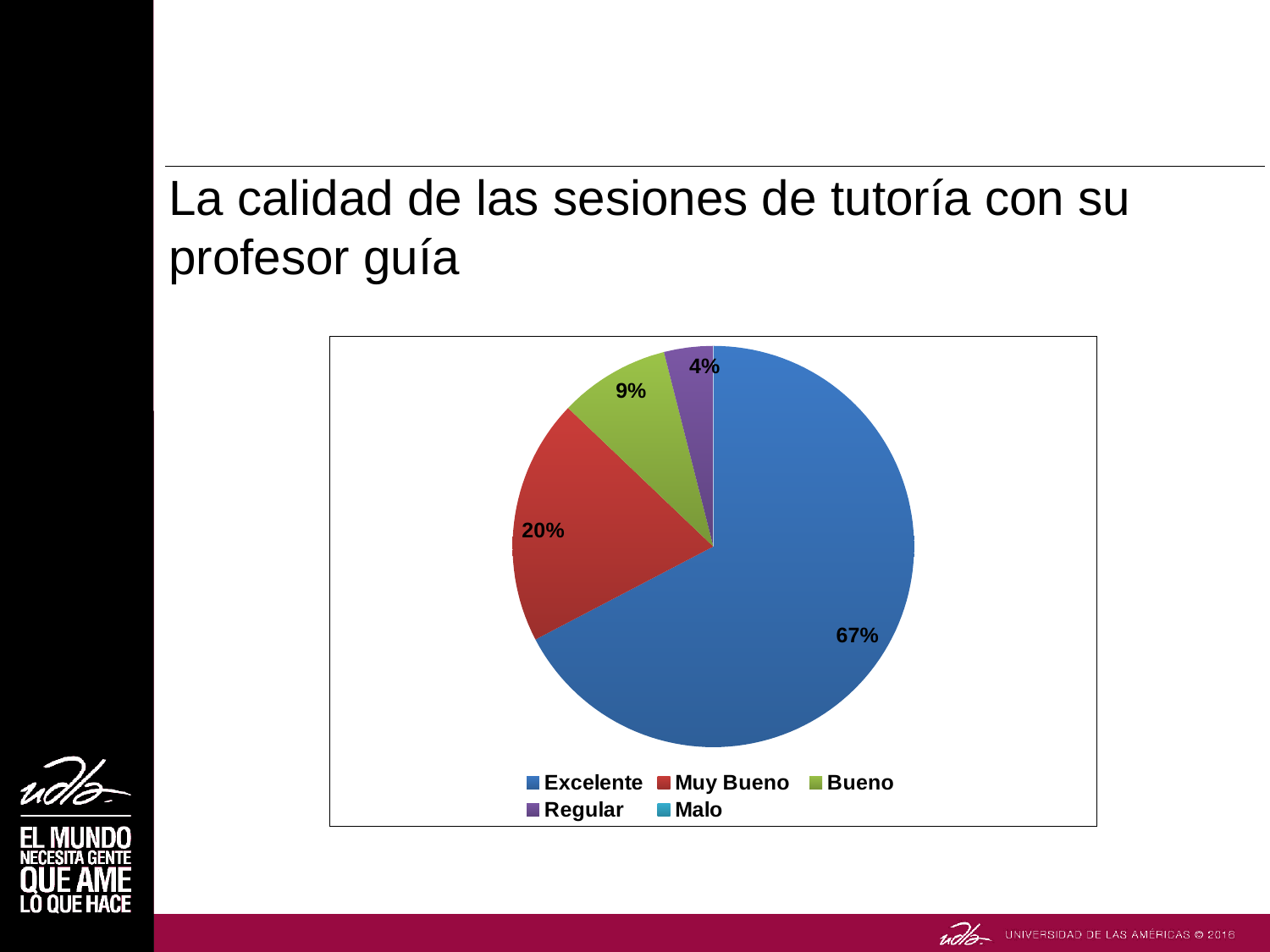
What colour is the Excelente slice? blue What is the difference in percentage points between the Excelente and Muy Bueno slices? 47 Which of the labelled slices is the smallest? Regular What percentage of the pie is labelled Muy Bueno? 20% What type of chart is shown on the slide? pie chart Which slice is larger, Bueno or Regular? Bueno What percentage of the pie is labelled Bueno? 9% Which legend entry has no visible slice in the pie? Malo Which category has the largest slice of the pie? Excelente What percentage of the pie is labelled Excelente? 67% How many categories does the legend list? 5 What percentage of the pie is labelled Regular? 4%